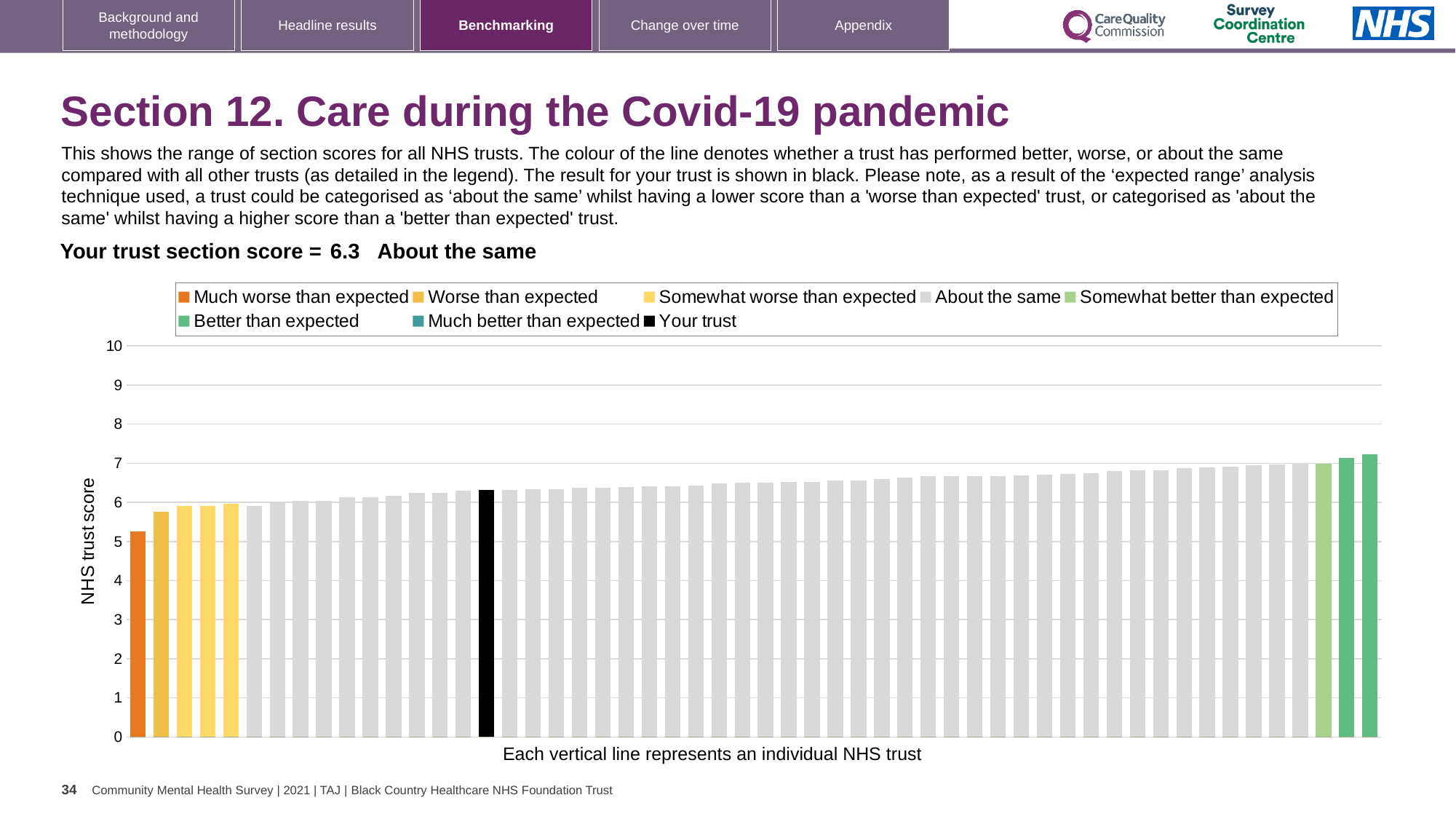
Do the bar values rise or fall from left to right along the x axis? rise How many bars are coloured orange for 'Much worse than expected'? 1 What kind of chart is shown on the slide? bar chart Which is larger, the value for your trust or the value of the orange 'Much worse than expected' bar? your trust How is your trust's section score categorised compared with other trusts? About the same How many entries does the chart legend list? 8 Is the value for your trust (the black bar) greater or less than 5? greater What is the section score for your trust? 6.3 What is the label on the vertical axis? NHS trust score Is the value of the lowest bar (the orange bar) greater or less than 6? less What colour is the bar representing your trust? black Is the value of the highest bar greater or less than 7? greater